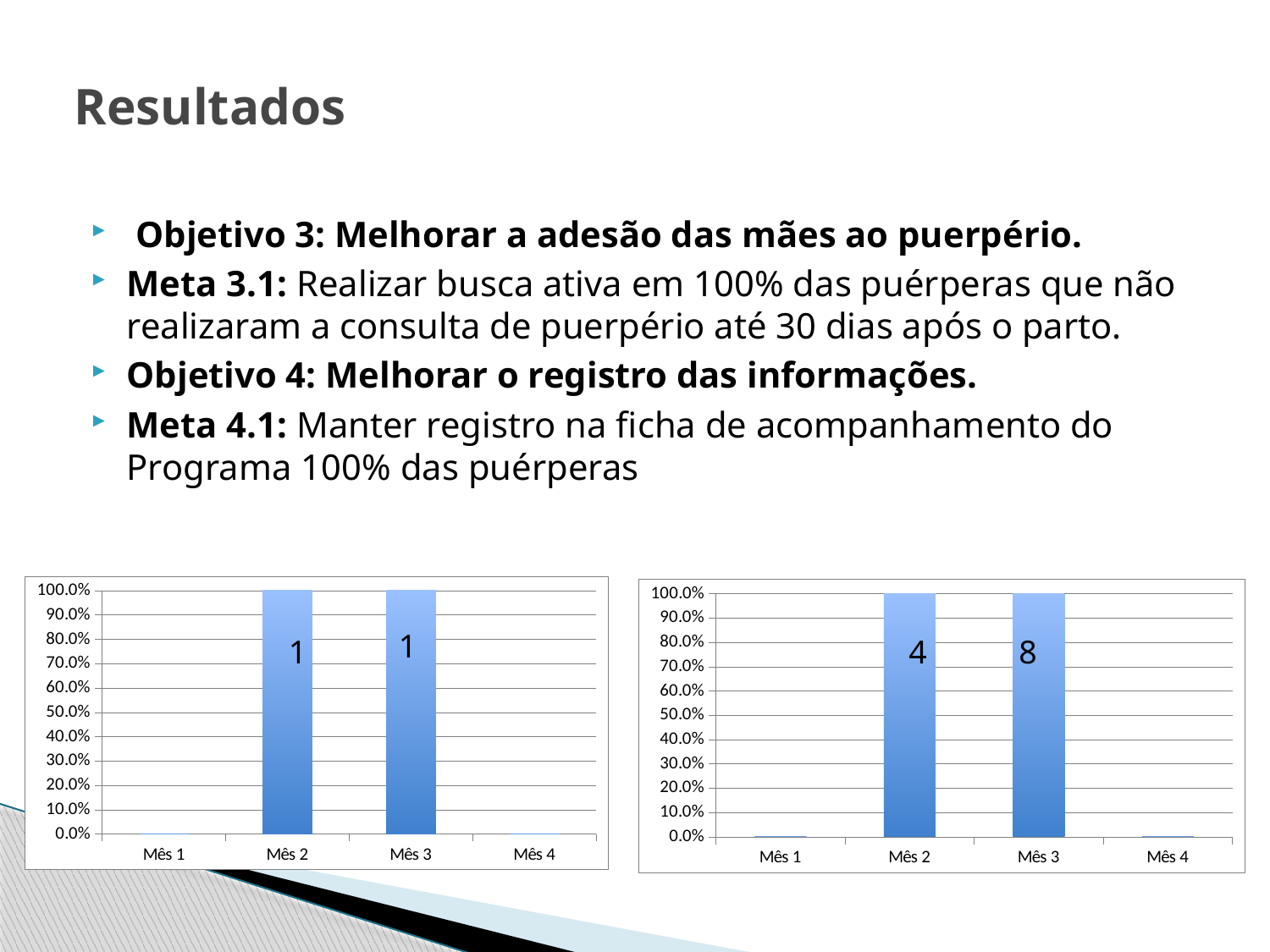
What kind of chart is the right chart? Bar chart In the right chart, what data label is shown on the bar for Mês 3? 8 In the right chart, is the value for Mês 1 greater or less than 10.0%? less What is the highest value shown on the vertical axis of the left chart? 100.0% In the left chart, what percentage on the vertical axis does the bar for Mês 2 reach? 100.0% How many categories are shown on the x axis of the left chart? 4 In the right chart, which has the larger data label, Mês 2 or Mês 3? Mês 3 In the right chart, what is the difference between the data labels for Mês 3 and Mês 2? 4 In the right chart, what percentage on the vertical axis does the bar for Mês 3 reach? 100.0% In the left chart, is the value for Mês 4 greater or less than 10.0%? less In the left chart, what data label is shown on the bar for Mês 2? 1 In the right chart, what data label is shown on the bar for Mês 2? 4